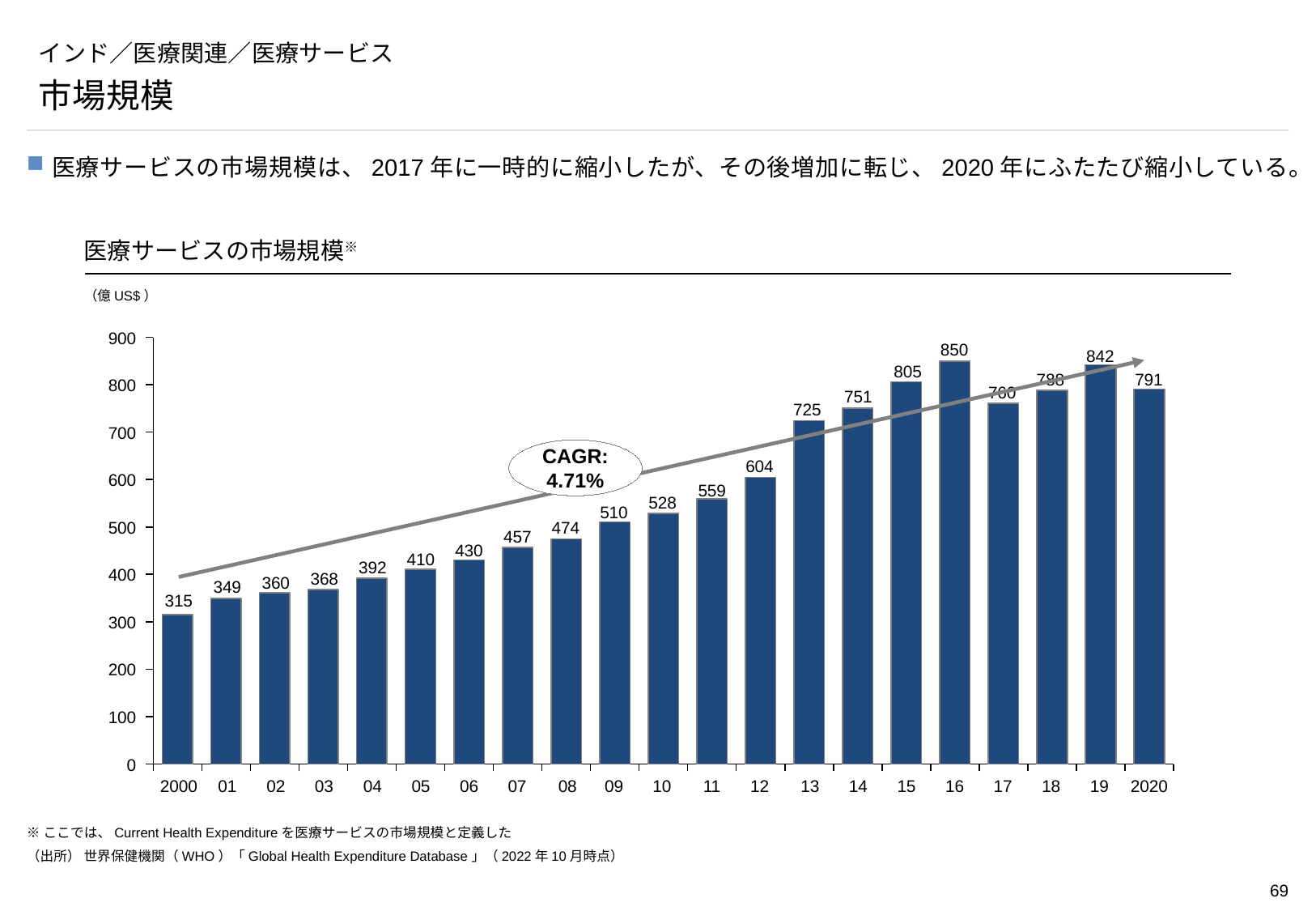
What is the difference between the values for 2019 and 2020? 51 Is the value for 2017 greater or less than 700? greater What is the market size value for 2016? 850 Which is larger, the value for 2012 or the value for 2013? 2013 Which year has the lowest market size? 2000 How many years are shown on the x axis? 21 Do the values rise or fall from 2000 to 2016? rise What kind of chart is shown on the slide? bar chart What is the market size value for 2012? 604 What is the market size value for 2000? 315 What CAGR is shown on the chart? 4.71% Which year has the highest market size? 2016